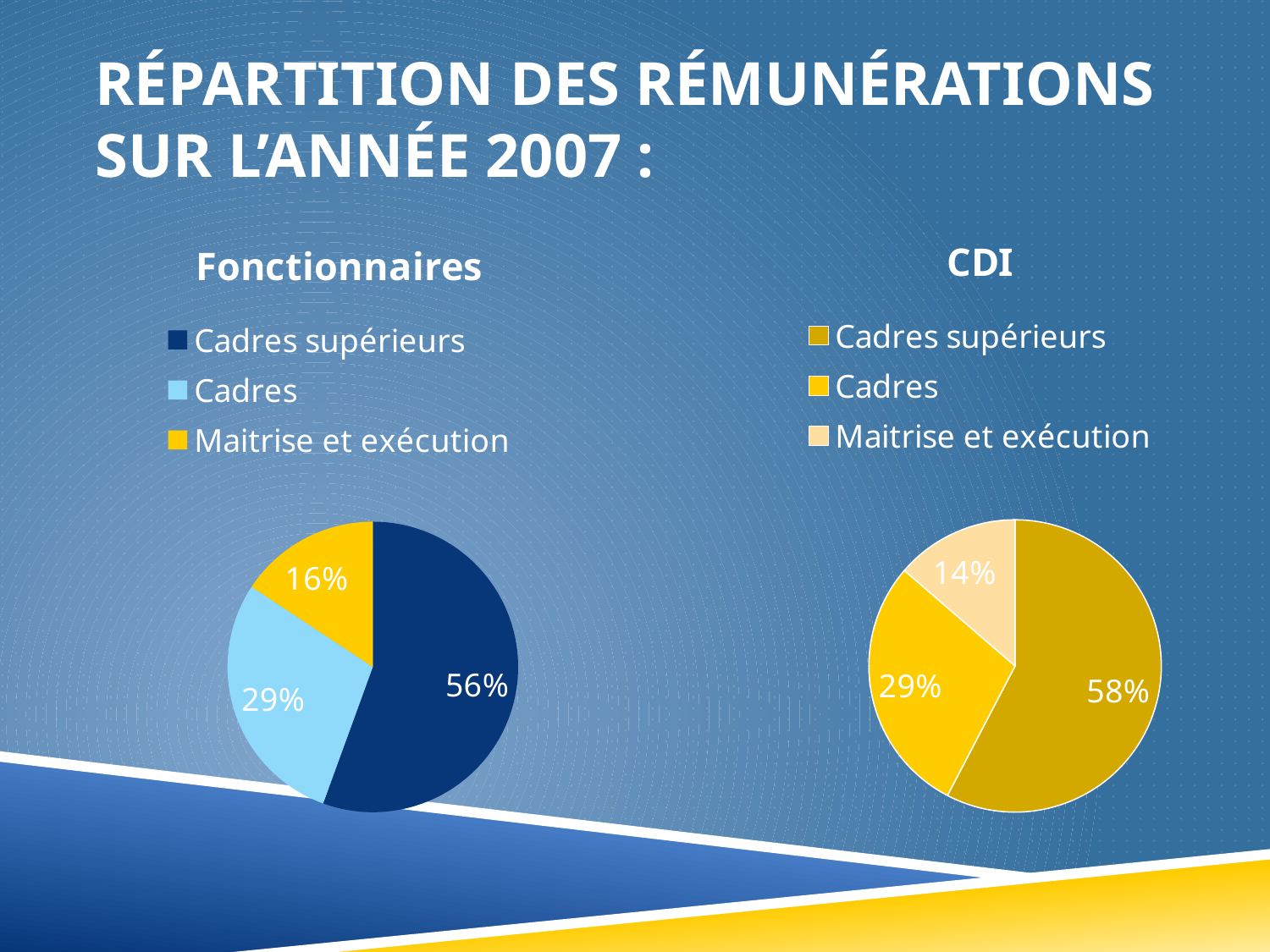
What colour is the Cadres slice in the Fonctionnaires chart? Light blue In the CDI chart, what share is shown for Cadres? 29% Which is larger: the Cadres supérieurs share in the CDI chart or in the Fonctionnaires chart? CDI In the CDI chart, what share is shown for Cadres supérieurs? 58% In the Fonctionnaires chart, what is the difference in percentage points between Cadres supérieurs and Cadres? 27 In the Fonctionnaires chart, what share is shown for Cadres supérieurs? 56% How many categories does the CDI chart show? 3 In the CDI chart, what share is shown for Maitrise et exécution? 14% What type of chart is the Fonctionnaires chart? Pie chart In the Fonctionnaires chart, what share is shown for Maitrise et exécution? 16% In the CDI chart, which category has the smallest slice? Maitrise et exécution In the Fonctionnaires chart, which category has the largest slice? Cadres supérieurs